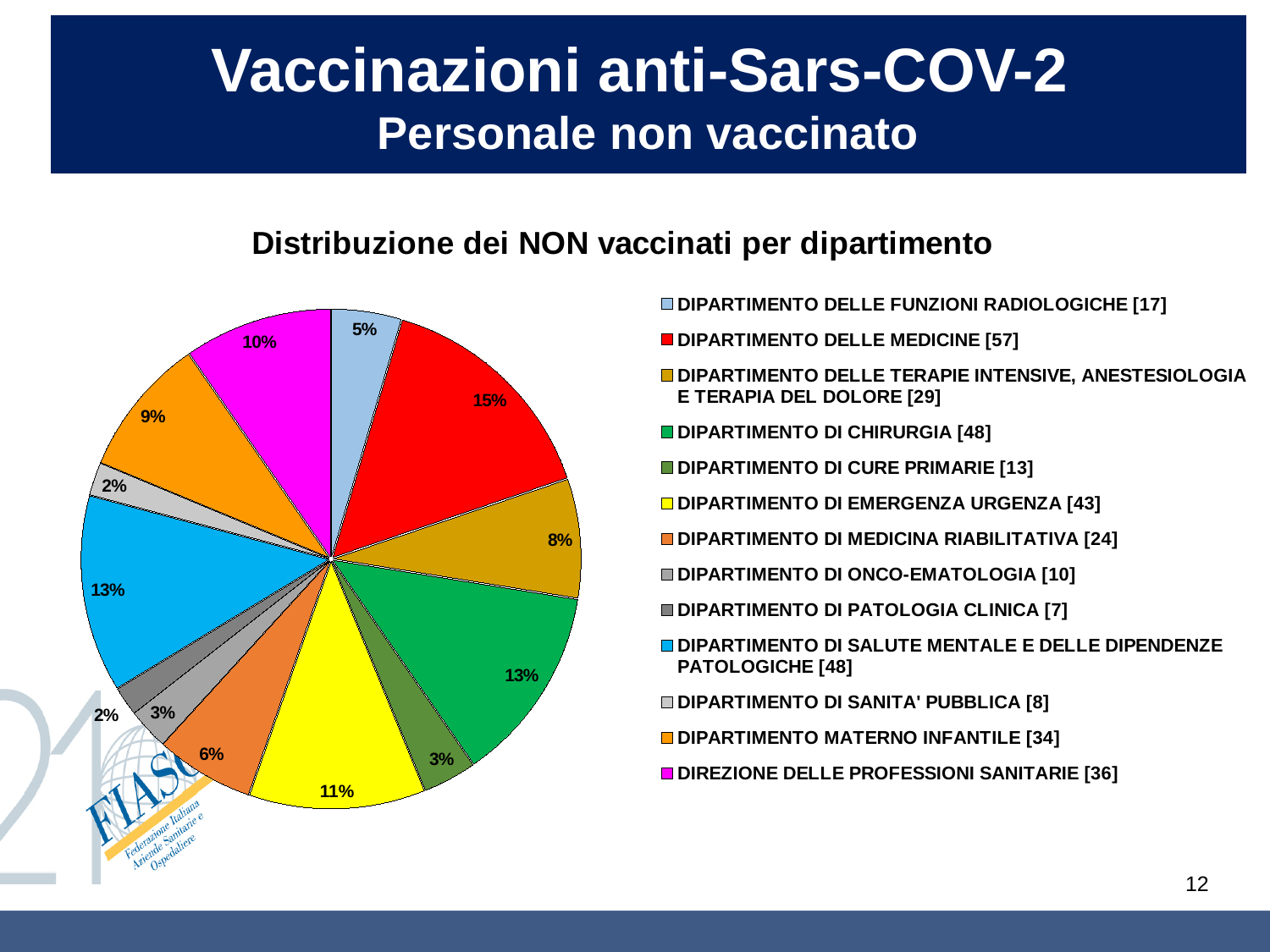
What percentage share does DIPARTIMENTO MATERNO INFANTILE have in the pie chart? 9% What is the difference in percentage points between the share of DIPARTIMENTO DELLE MEDICINE (15%) and DIPARTIMENTO DELLE TERAPIE INTENSIVE, ANESTESIOLOGIA E TERAPIA DEL DOLORE (8%)? 7 percentage points According to the legend, which department has the smallest number of non-vaccinated staff? DIPARTIMENTO DI PATOLOGIA CLINICA [7] How many non-vaccinated staff does the legend list for DIPARTIMENTO DI SALUTE MENTALE E DELLE DIPENDENZE PATOLOGICHE? 48 What is the title of the chart? Distribuzione dei NON vaccinati per dipartimento What percentage share does DIPARTIMENTO DI EMERGENZA URGENZA have in the pie chart? 11% Which department has the largest slice of the pie chart? DIPARTIMENTO DELLE MEDICINE How many slices does the pie chart have? 13 What percentage share does DIPARTIMENTO DELLE MEDICINE have in the pie chart? 15% What kind of chart is shown on the slide? pie chart Which has a larger share of the pie: DIPARTIMENTO DELLE MEDICINE or DIPARTIMENTO DI CHIRURGIA? DIPARTIMENTO DELLE MEDICINE What percentage share does DIREZIONE DELLE PROFESSIONI SANITARIE have in the pie chart? 10%